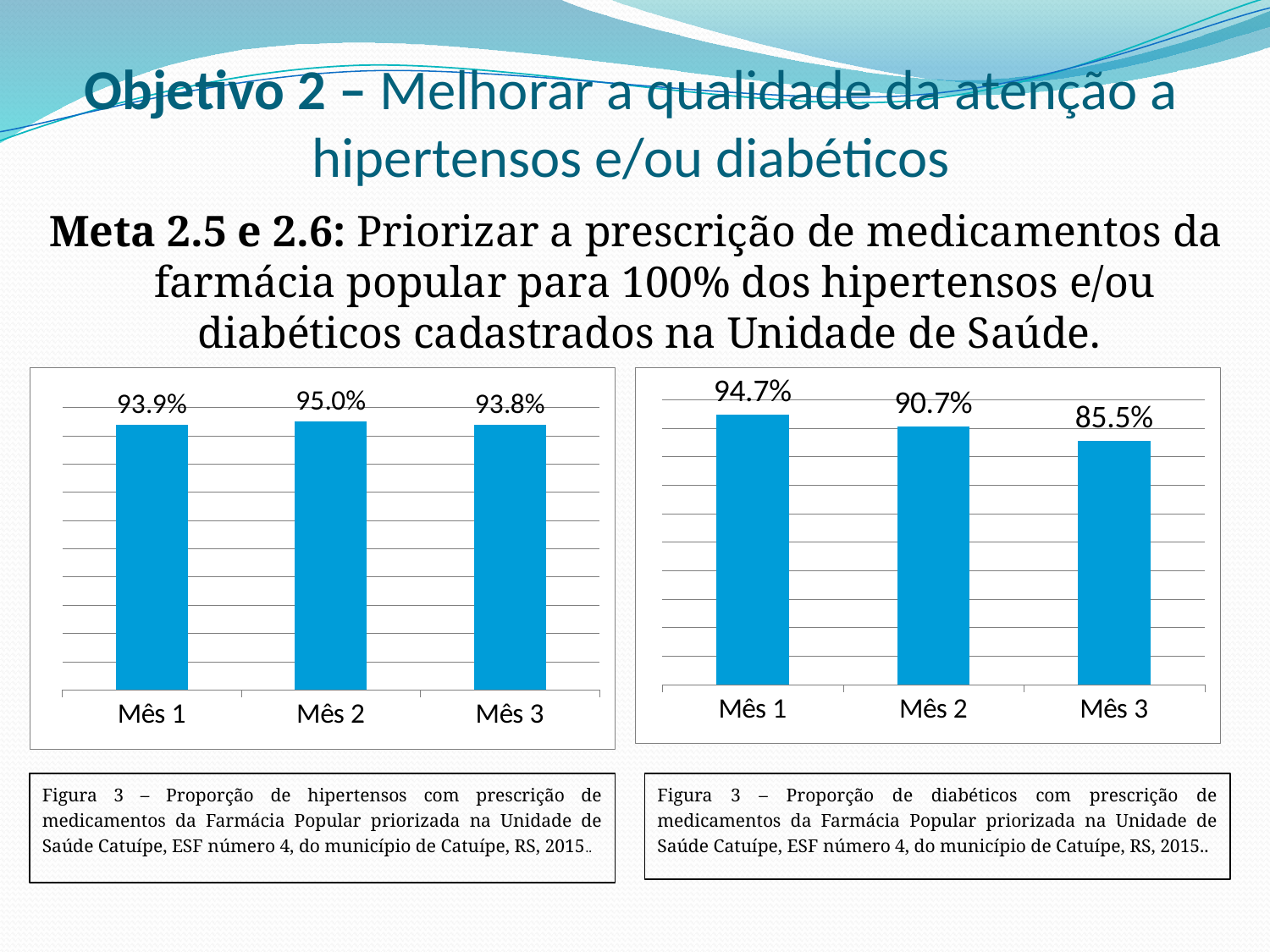
In the right chart (diabéticos), what is the value for Mês 1? 94.7% What kind of chart is the right chart (diabéticos)? bar chart In the right chart (diabéticos), which is larger, the value for Mês 1 or Mês 2? Mês 1 In the right chart (diabéticos), which month has the lowest value? Mês 3 How many months are shown in the left chart (hipertensos)? 3 In the left chart (hipertensos), what is the value for Mês 3? 93.8% In the left chart (hipertensos), which month has the highest value? Mês 2 In the right chart (diabéticos), which month has the highest value? Mês 1 In the right chart (diabéticos), do the values rise or fall from Mês 1 to Mês 3? fall In the left chart (hipertensos), what is the value for Mês 2? 95.0% In the right chart (diabéticos), what is the difference between the values for Mês 1 and Mês 3? 9.2% In the right chart (diabéticos), what is the value for Mês 3? 85.5%